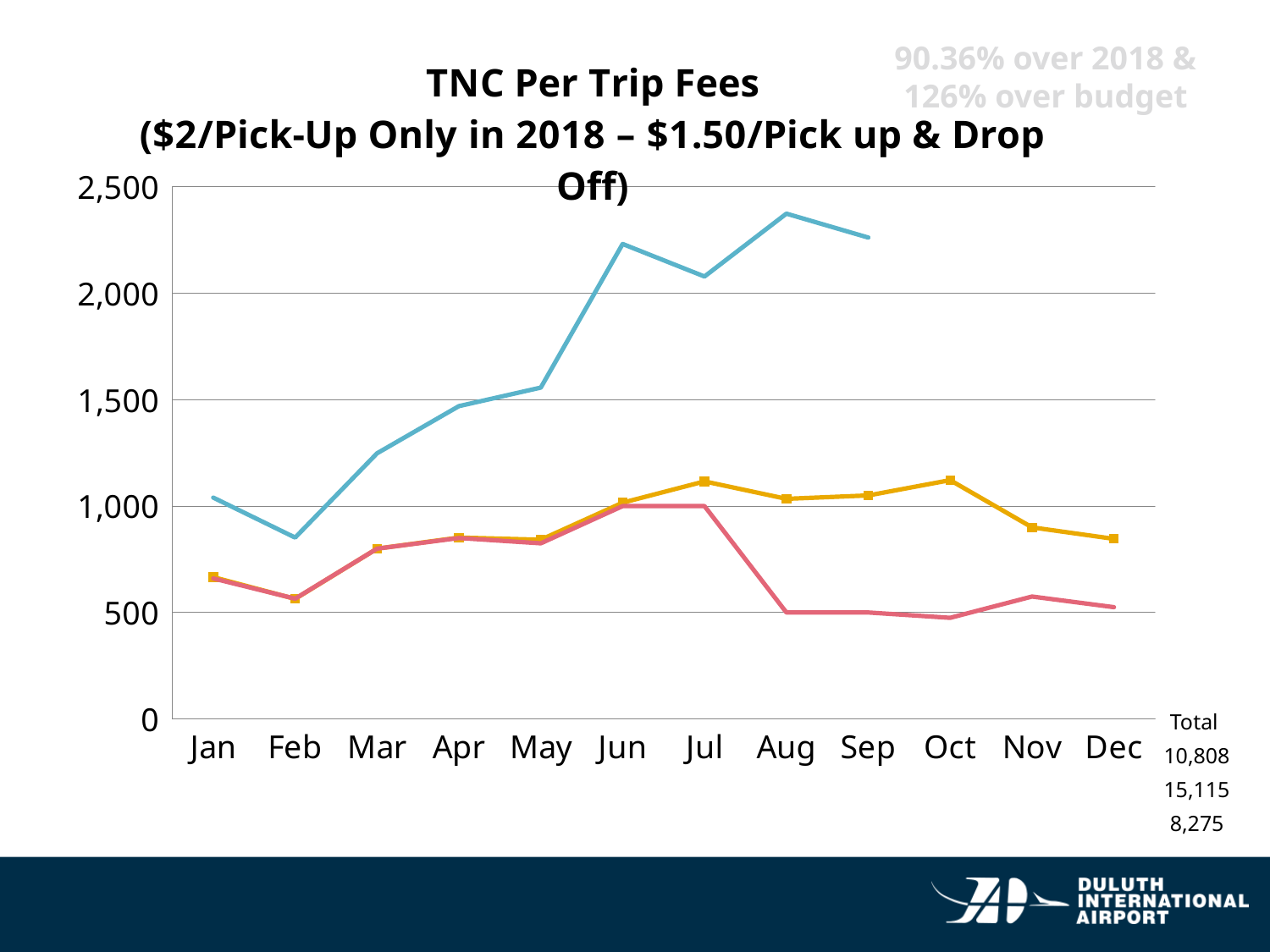
In Jun, which line has the larger value, the blue line or the orange line? blue line Does the blue line generally rise or fall from Jan to Sep? rise What percentage over budget does the annotation at the top right of the slide state? 126% Is the value of the blue line in Jun greater or less than 2,000? greater In which month does the blue line reach its highest value? Aug What kind of chart is shown on the slide? line chart Is the value of the blue line in Mar greater or less than 1,000? greater For the red line, which month has the larger value, Jul or Aug? Jul How many months are shown on the x axis? 12 In which month does the orange line reach its lowest value? Feb Is the value of the red line in Aug greater or less than 1,000? less In which month does the blue line reach its lowest value? Feb